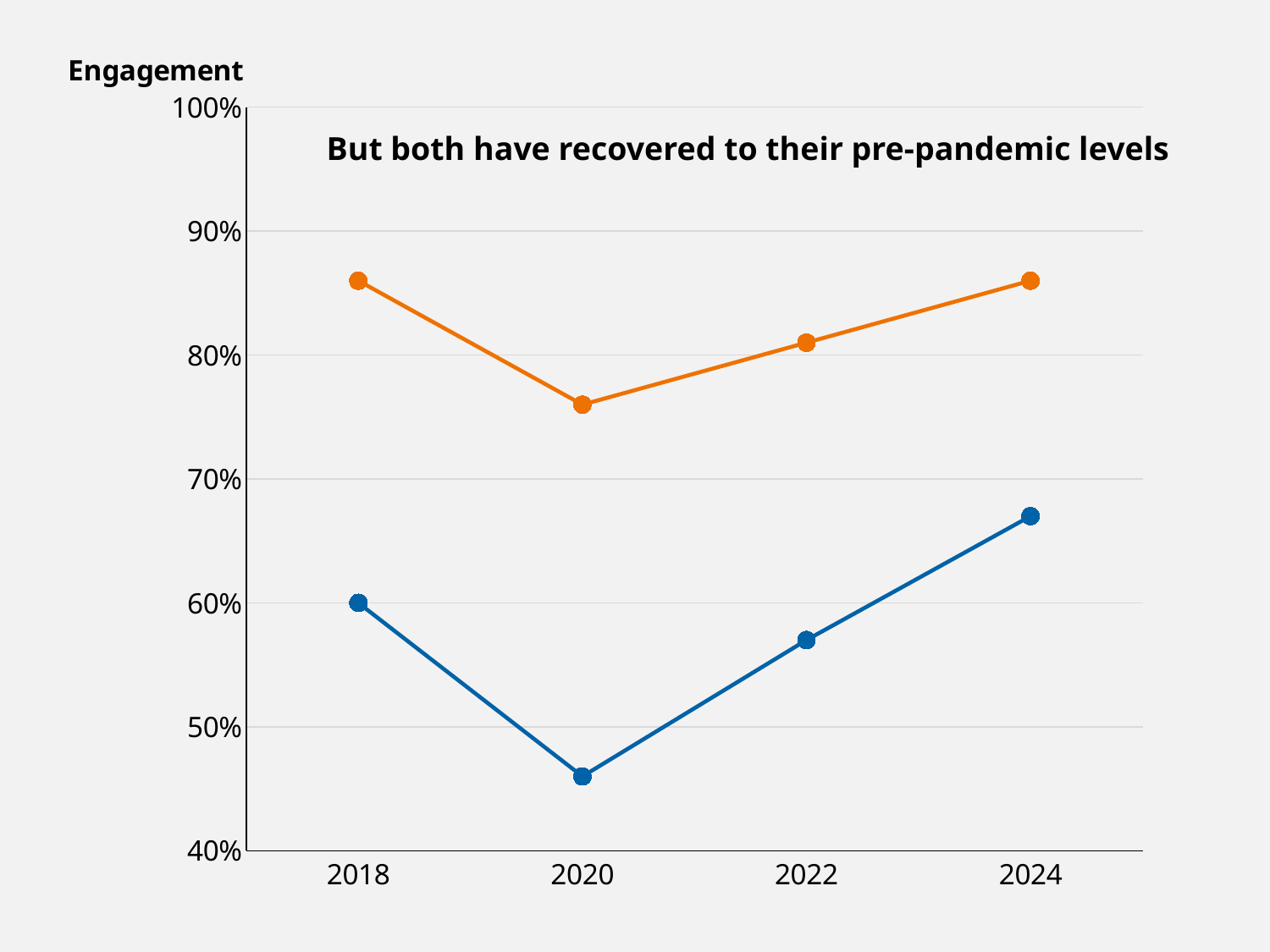
How many years are plotted on the x axis? 4 Is the value of the blue line in 2024 greater or less than 70%? less What is the value of the blue line in 2018? 60% What is the label on the vertical axis of the chart? Engagement In which year does the blue line reach its lowest value? 2020 Does the blue line rise or fall from 2020 to 2024? rise What kind of chart is shown on the slide? line chart Is the value of the blue line in 2020 greater or less than 50%? less In 2020, which line has the higher value, the orange or the blue? orange Is the value of the orange line in 2018 greater or less than 80%? greater